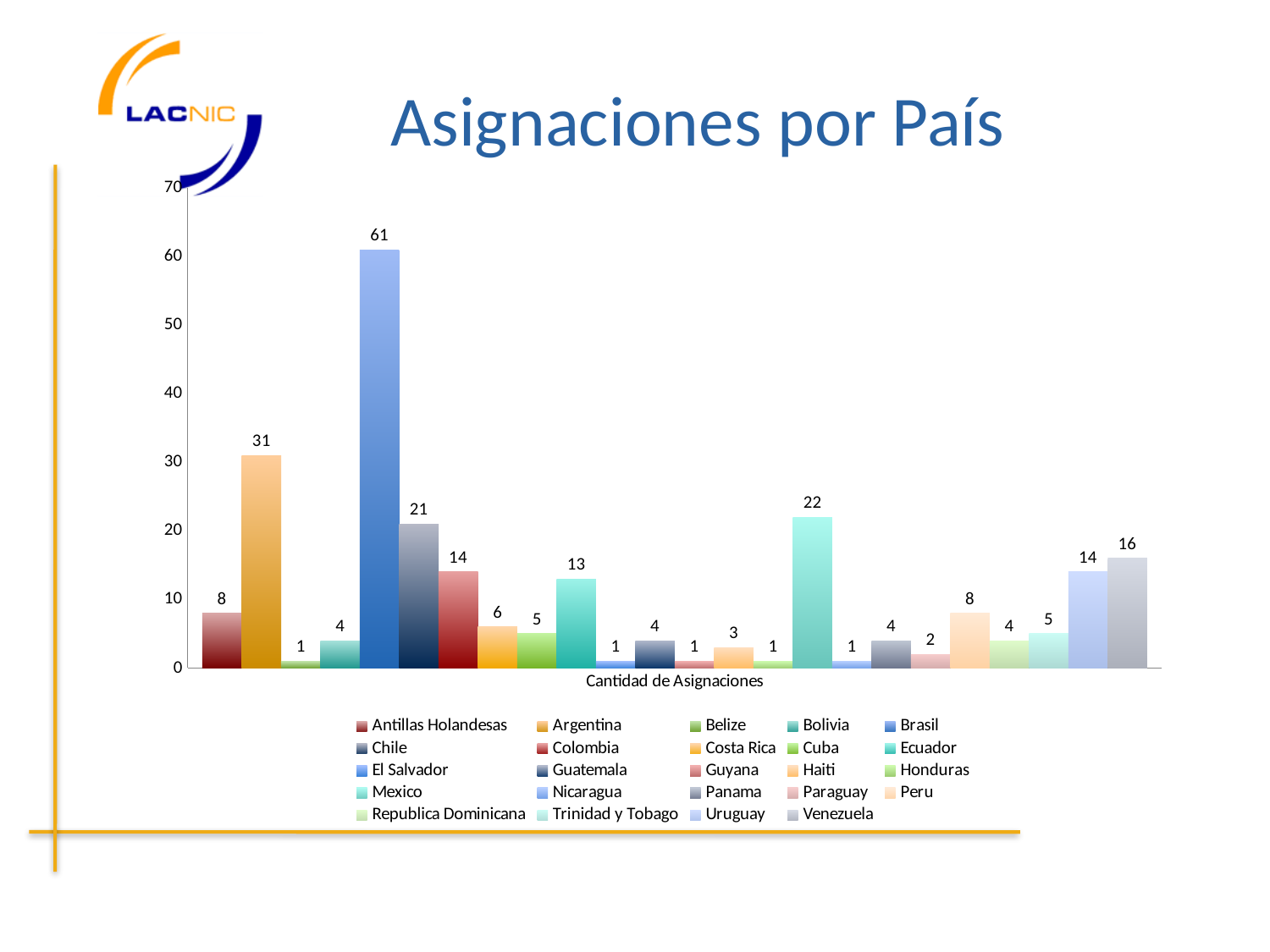
What is the difference between the values for Venezuela and Uruguay? 2 What is the value for Chile? 21 What is the value for Mexico? 22 What is the title of the chart? Asignaciones por País What is the value for Argentina? 31 How many series does the legend list? 24 What is the difference between the values for Brasil and Argentina? 30 Which country has the highest number of asignaciones? Brasil What type of chart is shown on the slide? bar chart Is the value for Venezuela greater or less than 10? greater What is the value for Brasil? 61 Which is larger, the value for Mexico or the value for Chile? Mexico